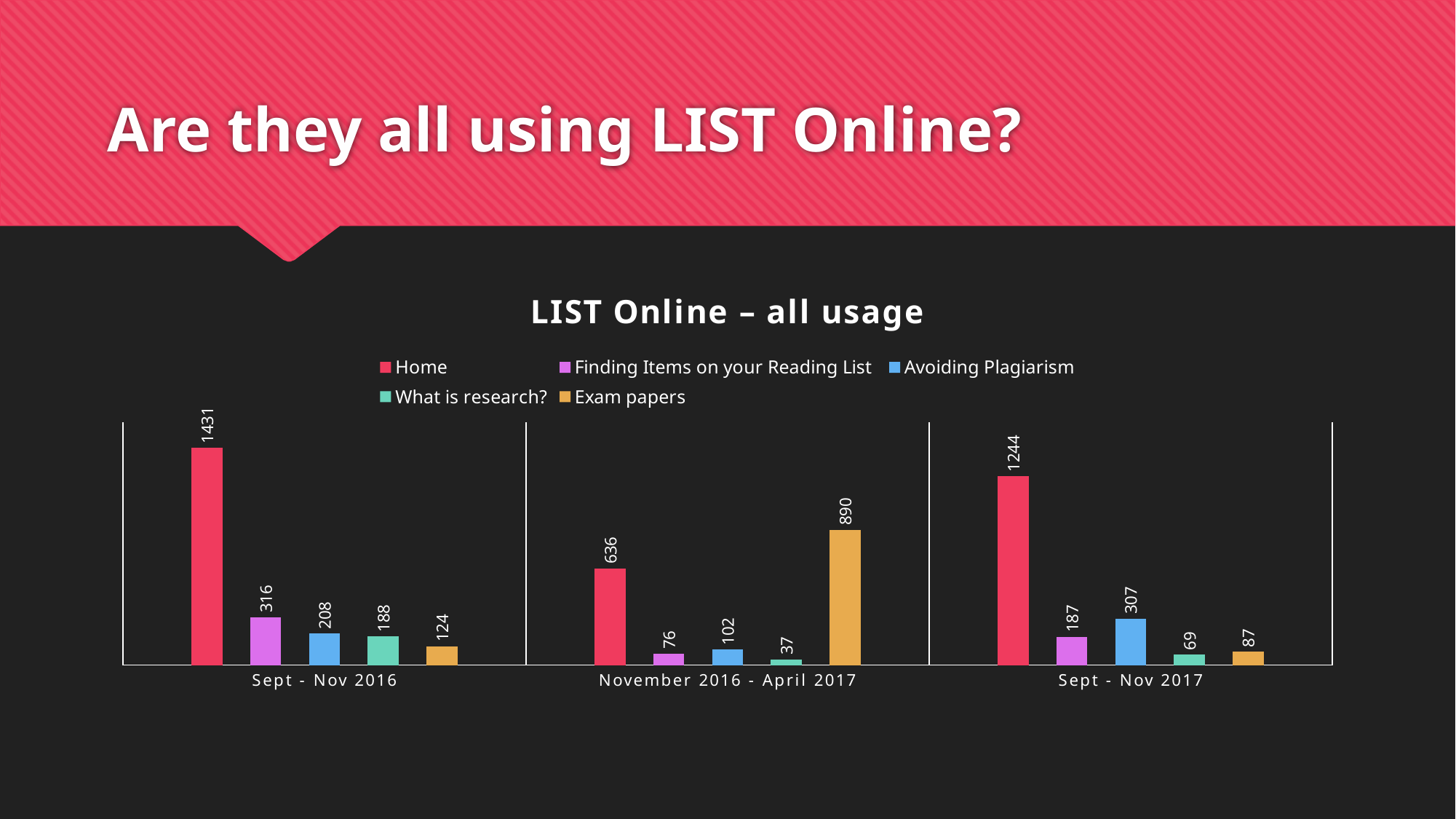
What is the value for Avoiding Plagiarism in Sept - Nov 2017? 307 How many series does the legend list? 5 What is the value for What is research? in November 2016 - April 2017? 37 What is the difference between the Home values for Sept - Nov 2016 and Sept - Nov 2017? 187 What is the value for Exam papers in November 2016 - April 2017? 890 How many time periods are shown on the x axis? 3 What kind of chart is shown? Bar chart Which series has the highest value in Sept - Nov 2017? Home What is the value for Home in Sept - Nov 2016? 1431 Which is larger in November 2016 - April 2017: Home or Exam papers? Exam papers Which series has the lowest value in Sept - Nov 2016? Exam papers What is the title of the chart? LIST Online – all usage